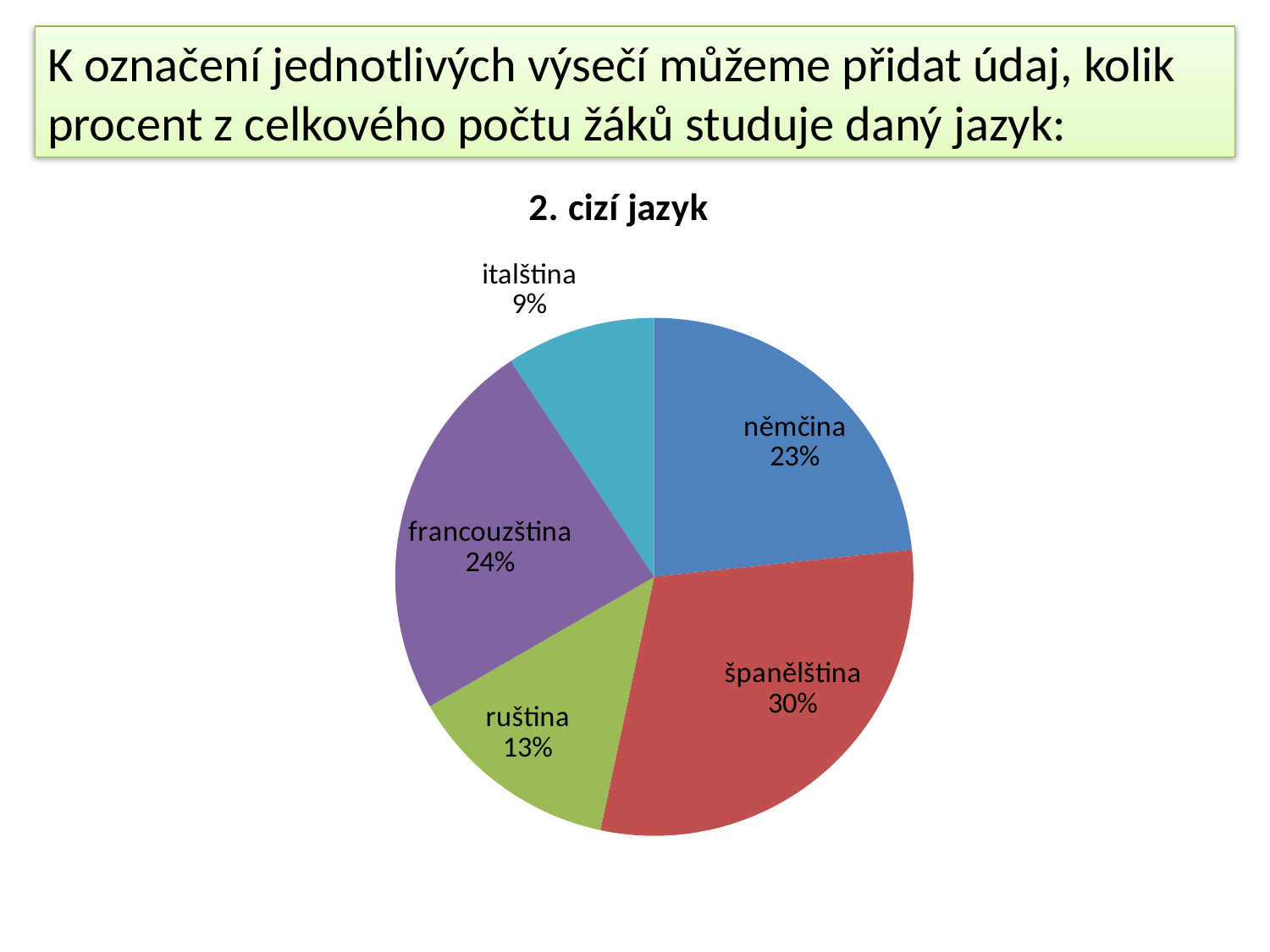
What percentage is shown for němčina? 23% Which language has the largest share of the pie? španělština What percentage is shown for ruština? 13% What percentage of the pie is labelled for španělština? 30% What is the title of the chart? 2. cizí jazyk Which language has the smallest share of the pie? italština How many slices does the pie chart have? 5 What colour is the slice for španělština? red What percentage is shown for italština? 9% Which has a larger share, francouzština or němčina? francouzština What type of chart is shown on the slide? pie chart What is the difference in percentage points between španělština and ruština? 17